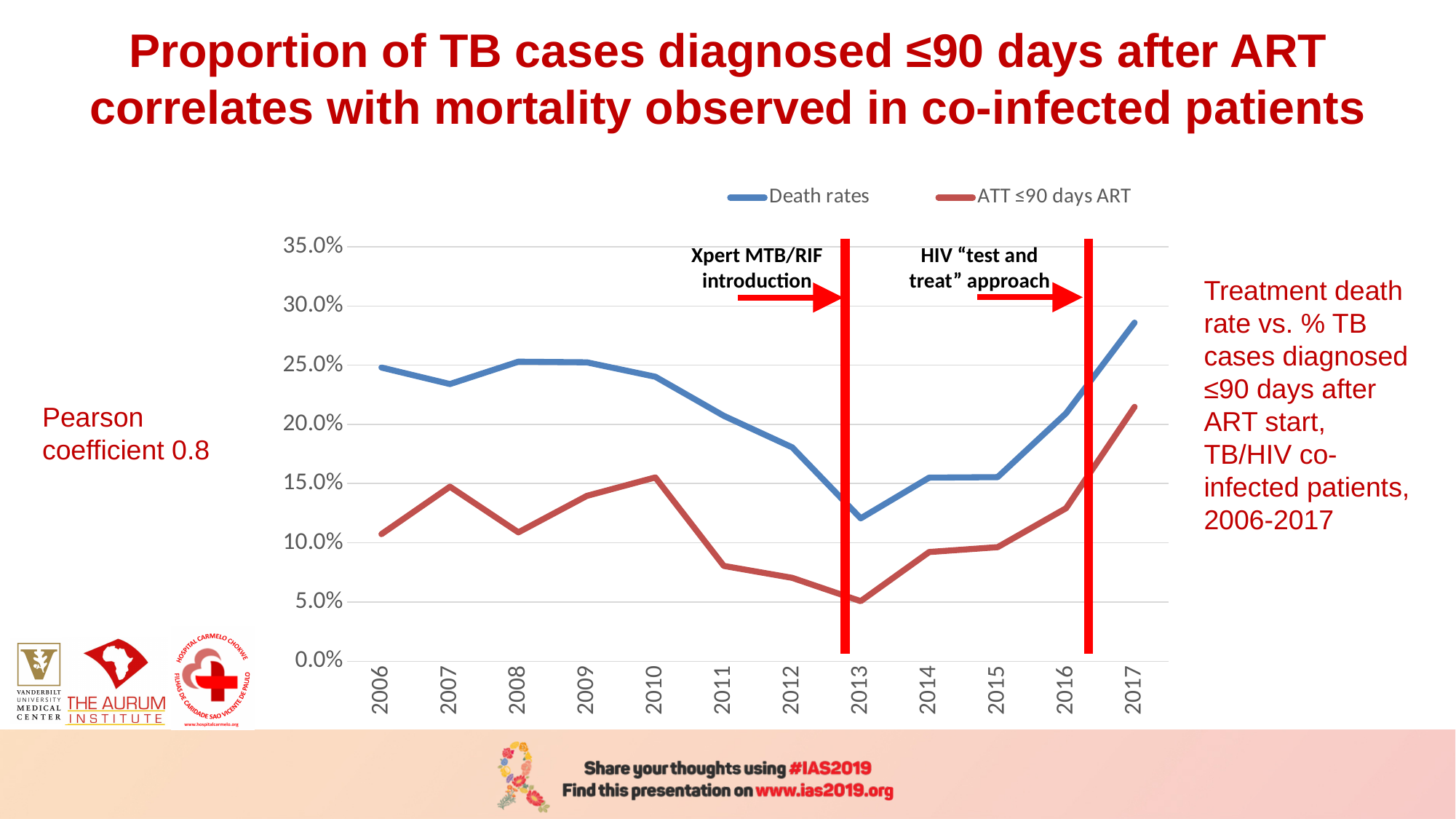
How many series does the legend list? 2 Is the Death rates value for 2012 greater or less than 20.0%? less Which series has the higher value in 2010, Death rates or ATT ≤90 days ART? Death rates In which year is the ATT ≤90 days ART series at its lowest? 2013 In which year is the Death rates series at its lowest? 2013 Do the Death rates rise or fall from 2013 to 2017? rise Which intervention is annotated at the first red vertical line on the chart? Xpert MTB/RIF introduction In which year is the Death rates series at its highest? 2017 Is the Death rates value for 2017 greater or less than 25.0%? greater Is the ATT ≤90 days ART value for 2013 greater or less than 10.0%? less How many years are plotted along the x axis? 12 What kind of chart is shown on the slide? line chart